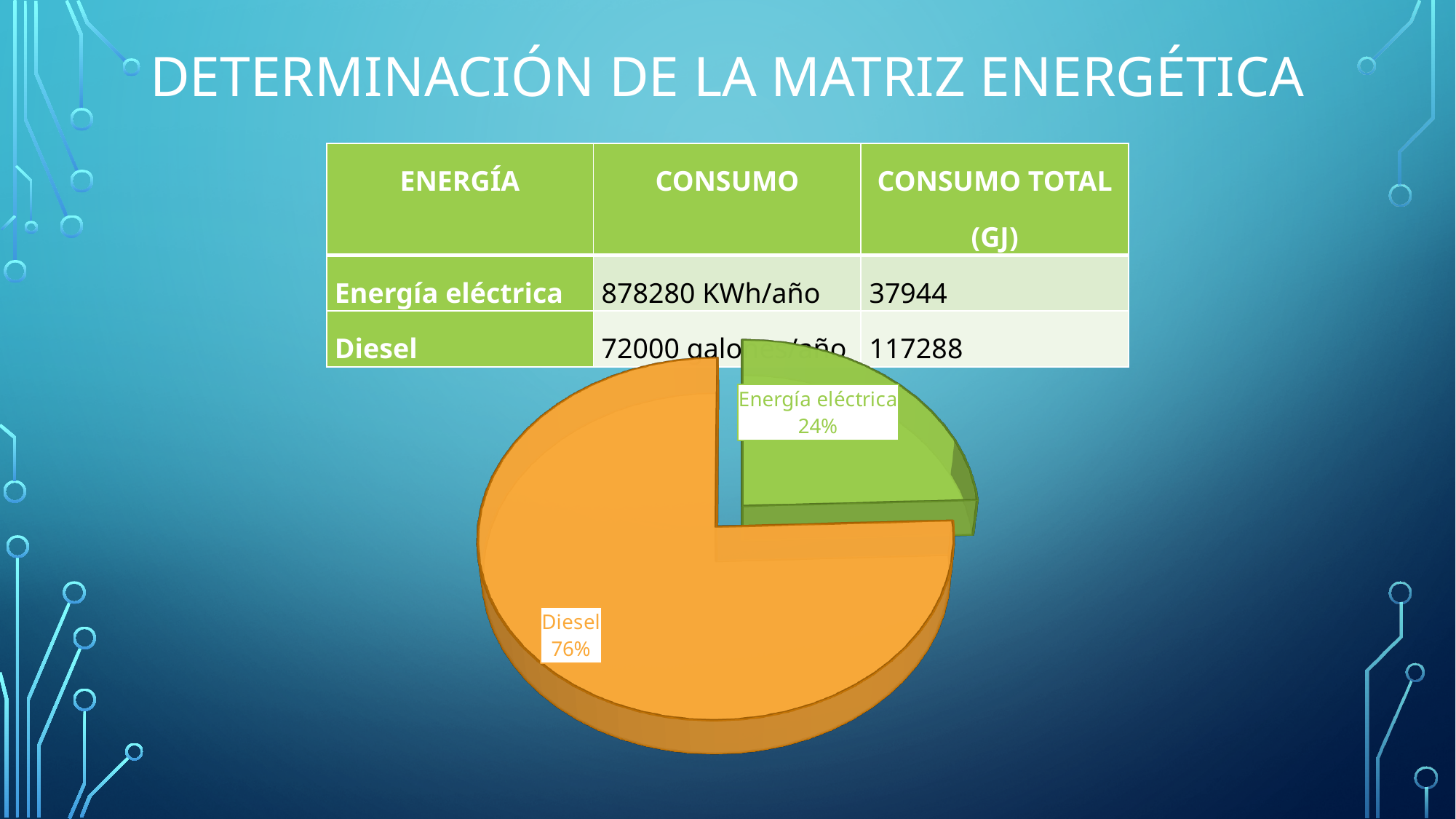
What colour is the Diesel slice of the pie? Orange Which slice of the pie is the largest? Diesel Is the share for Diesel greater or less than 50%? greater What colour is the Energía eléctrica slice of the pie? Green How many slices does the pie chart have? 2 What share of the pie does Diesel represent? 76% What is the difference in percentage points between the Diesel slice and the Energía eléctrica slice? 52 What kind of chart is shown on the slide? Pie chart Which slice of the pie is the smallest? Energía eléctrica What share of the pie does Energía eléctrica represent? 24% Which is larger, the Diesel slice or the Energía eléctrica slice? Diesel